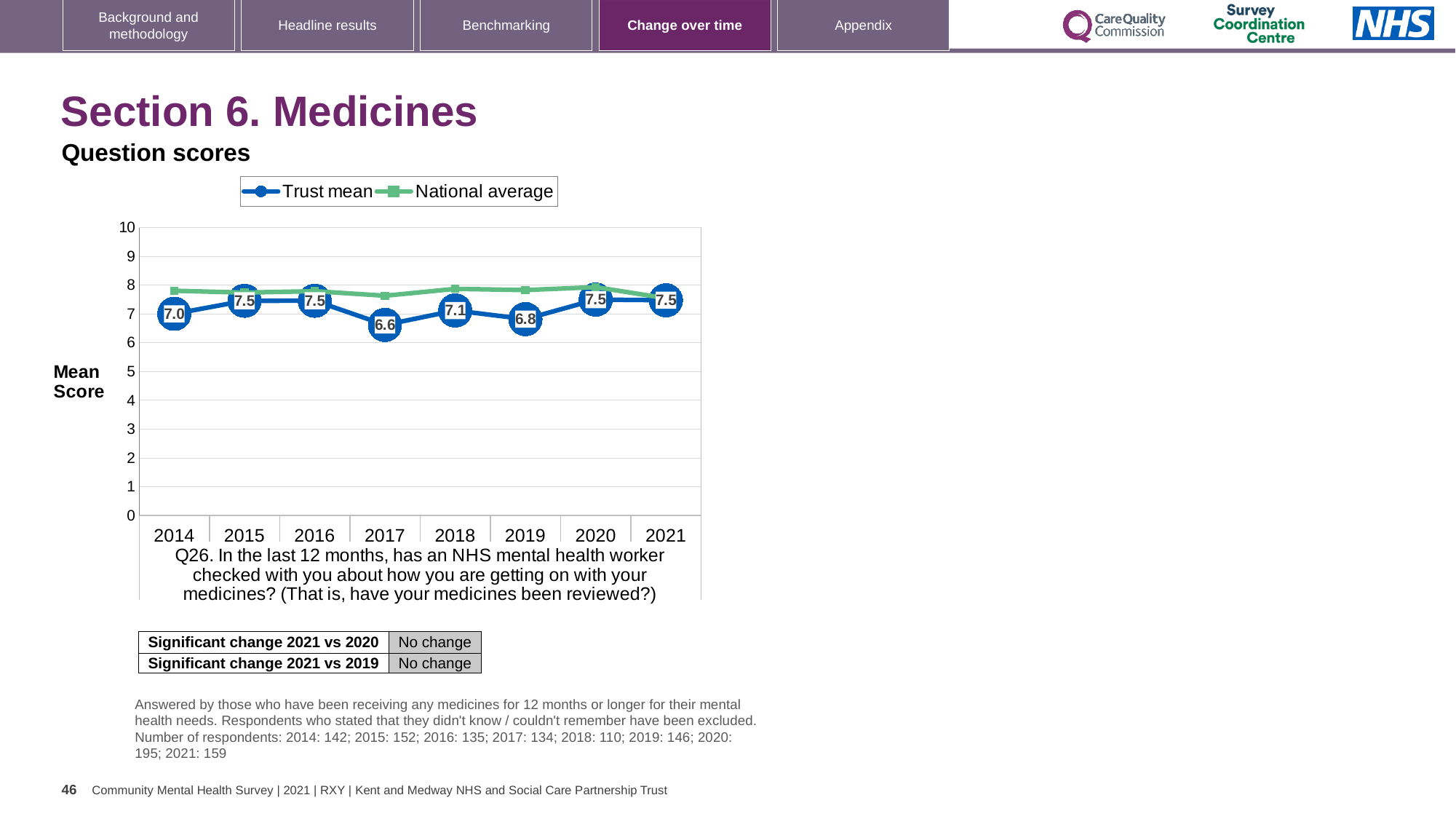
What is the Trust mean score for 2017? 6.6 What is the label on the y axis of the chart? Mean Score How many series does the legend list? 2 What is the Trust mean score for 2014? 7.0 Does the Trust mean score rise or fall from 2017 to 2018? Rise How many years are shown on the x axis of the chart? 8 What is the difference between the Trust mean scores for 2016 and 2017? 0.9 What is the Trust mean score for 2019? 6.8 In which year is the Trust mean score lowest? 2017 What kind of chart is shown on the slide? Line chart Which year has the higher Trust mean score, 2018 or 2019? 2018 Is the National average value for 2014 greater or less than 7? greater